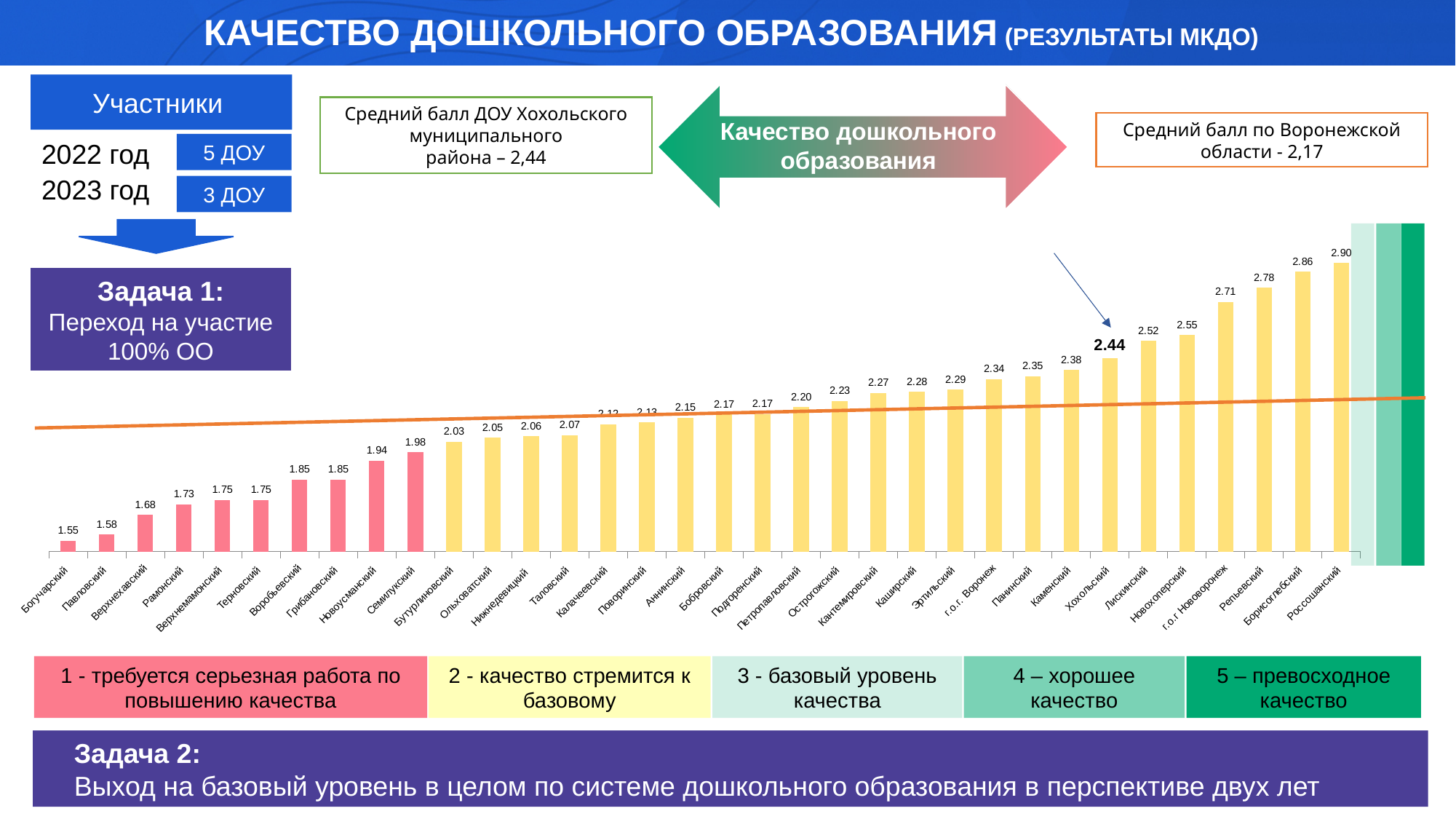
What is the difference between the values for Россошанский and Богучарский? 1.35 Which category has the highest value? Россошанский What is the value for Хохольский? 2.44 How many categories are plotted on the chart? 34 What is the value for Богучарский? 1.55 How many bars are coloured pink (red) on the chart? 10 Which is larger, the value for Репьевский or the value for г.о.г. Нововоронеж? Репьевский What kind of chart is shown on the slide? bar chart What is the value for Лискинский? 2.52 Do the values rise or fall from left to right along the x axis? rise What is the difference between the values for Хохольский and Каменский? 0.06 Which category has the lowest value? Богучарский